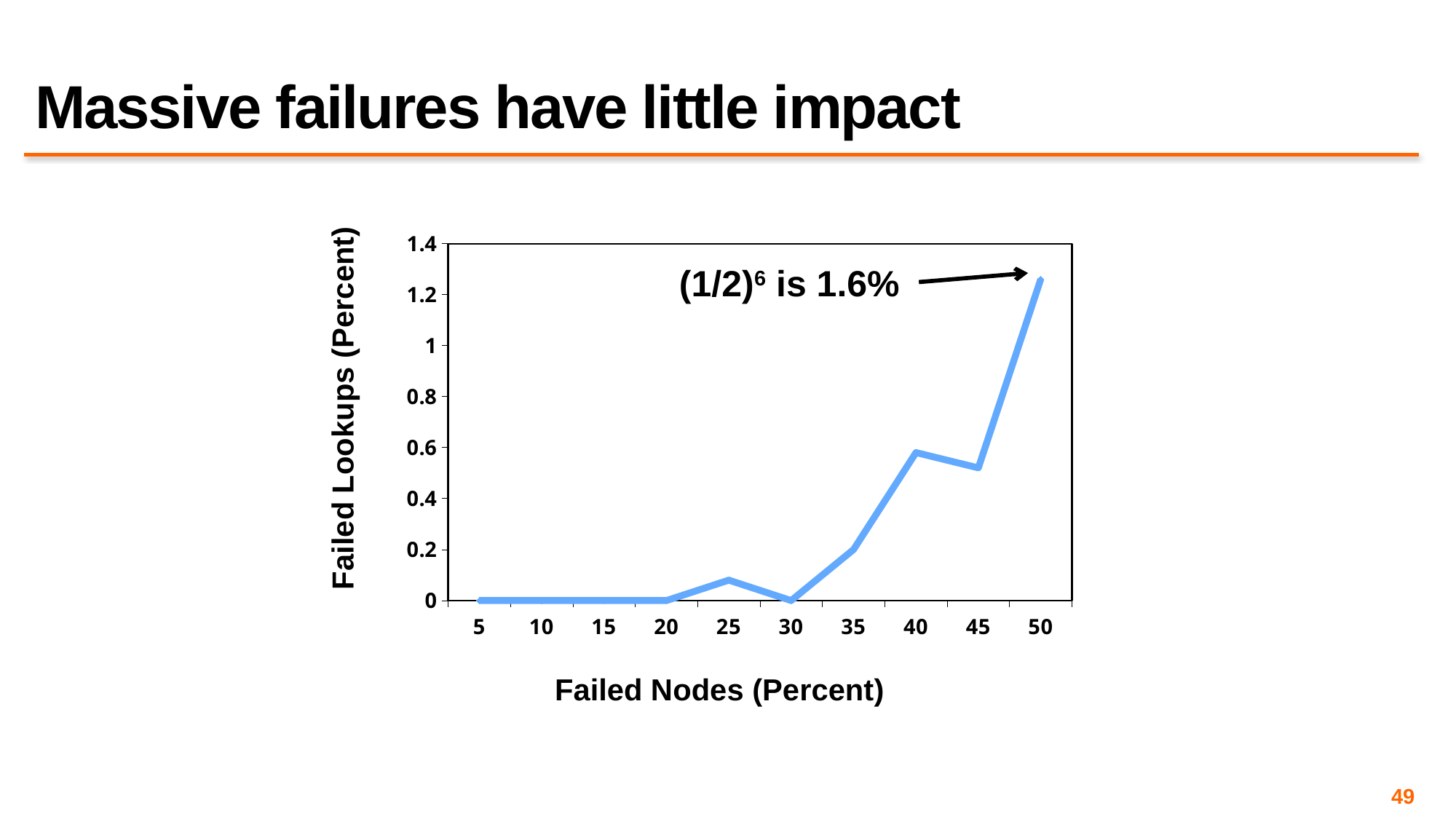
How many data points are plotted along the x axis? 10 Is the Failed Lookups value at 50 percent failed nodes greater or less than 1? greater What is the Failed Lookups value when Failed Nodes is 20 percent? 0 Overall, do Failed Lookups rise or fall as Failed Nodes increases from 5 to 50 percent? rise At which Failed Nodes percentage is the Failed Lookups value highest? 50 Is the Failed Lookups value at 40 percent failed nodes greater or less than 0.4? greater What is the label of the x axis? Failed Nodes (Percent) What kind of chart is shown on the slide? line chart Which has a larger Failed Lookups value: 40 percent failed nodes or 50 percent failed nodes? 50 percent failed nodes What is the Failed Lookups value when Failed Nodes is 30 percent? 0 What is the Failed Lookups value when Failed Nodes is 5 percent? 0 Is the Failed Lookups value at 45 percent failed nodes greater or less than 0.6? less